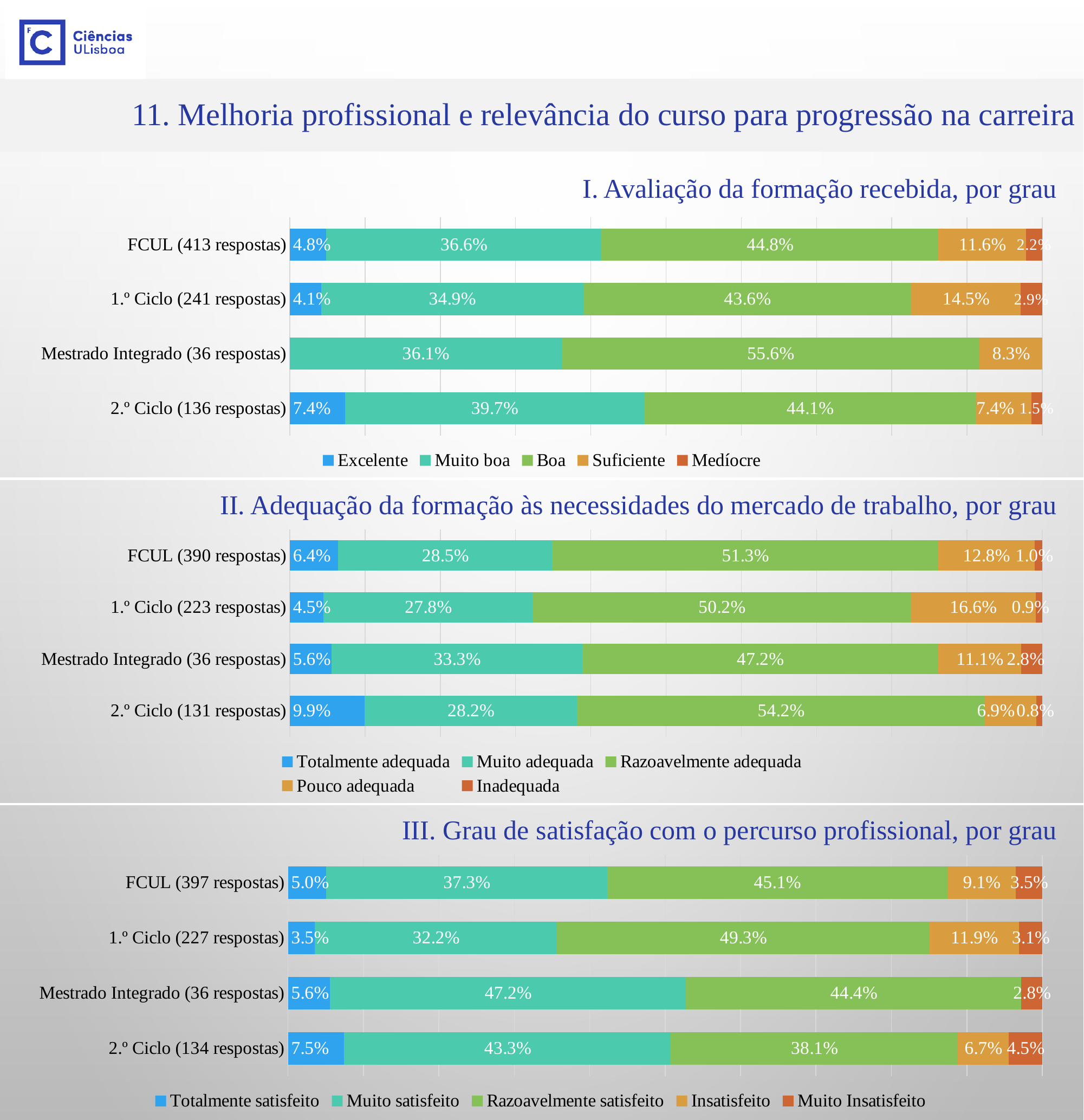
What type of chart is chart I (Avaliação da formação recebida, por grau)? Stacked bar chart In chart I (Avaliação da formação recebida, por grau), which degree has the highest "Excelente" share? 2.º Ciclo (136 respostas) How many series does the legend of chart III (Grau de satisfação com o percurso profissional, por grau) list? 5 In chart II (Adequação da formação às necessidades do mercado de trabalho, por grau), what is the "Razoavelmente adequada" value for 2.º Ciclo? 54.2% In chart III (Grau de satisfação com o percurso profissional, por grau), which degree has the highest "Muito Insatisfeito" share? 2.º Ciclo (134 respostas) In chart I (Avaliação da formação recebida, por grau), what percentage of FCUL responses rated the training as "Boa"? 44.8% In chart I (Avaliação da formação recebida, por grau), what is the "Muito boa" value for Mestrado Integrado? 36.1% In chart II (Adequação da formação às necessidades do mercado de trabalho, por grau), which degree has the lowest "Pouco adequada" share? 2.º Ciclo (131 respostas) In chart III (Grau de satisfação com o percurso profissional, por grau), what is the difference between the "Razoavelmente satisfeito" values for 1.º Ciclo and 2.º Ciclo? 11.2% In chart II (Adequação da formação às necessidades do mercado de trabalho, por grau), is the "Totalmente adequada" value larger for FCUL or for 1.º Ciclo? FCUL In chart III (Grau de satisfação com o percurso profissional, por grau), what is the "Muito satisfeito" value for Mestrado Integrado? 47.2% In chart I (Avaliação da formação recebida, por grau), what is the difference between the "Suficiente" values for 1.º Ciclo and 2.º Ciclo? 7.1%